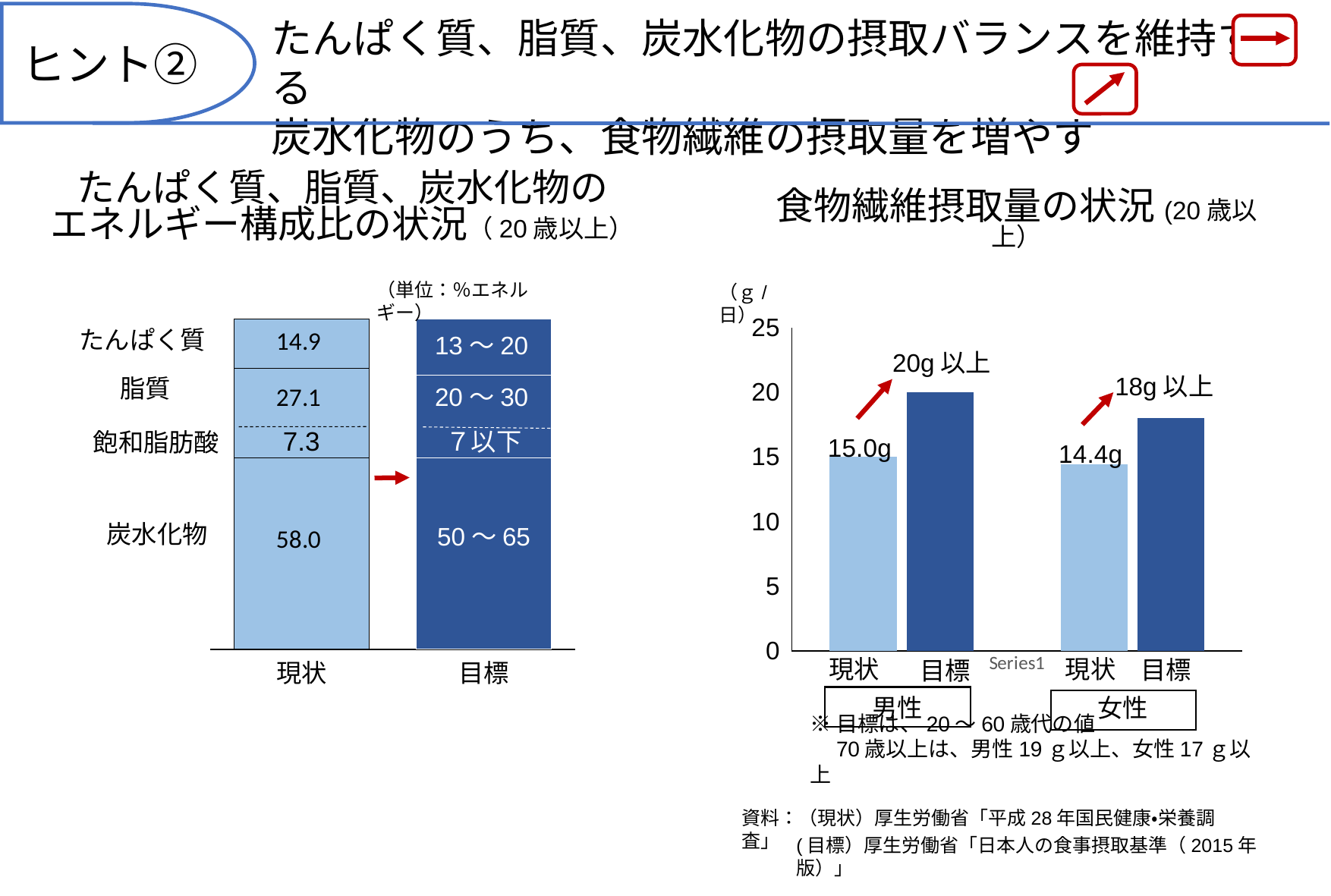
In the right chart (食物繊維摂取量の状況), which is larger, the 現状 value for 男性 or for 女性? 男性 In the left chart (エネルギー構成比の状況), which nutrient has the largest 現状 share? 炭水化物 In the right chart (食物繊維摂取量の状況), what is the 目標 label shown for 女性? 18g以上 What kind of chart is the right chart (食物繊維摂取量の状況)? bar chart In the left chart (エネルギー構成比の状況), what is the difference between the 現状 values for 炭水化物 and たんぱく質? 43.1 In the right chart (食物繊維摂取量の状況), what is the 現状 value for 女性? 14.4g In the left chart (エネルギー構成比の状況), what is the 目標 shown for 飽和脂肪酸? 7以下 In the right chart (食物繊維摂取量の状況), is the 目標 bar for 男性 greater or less than 15? greater In the left chart (エネルギー構成比の状況), what is the 現状 value for 炭水化物? 58.0 In the left chart (エネルギー構成比の状況), what is the 目標 range shown for 脂質? 20〜30 In the left chart (エネルギー構成比の状況), what is the 現状 value for たんぱく質? 14.9 In the right chart (食物繊維摂取量の状況), what is the 現状 value for 男性? 15.0g